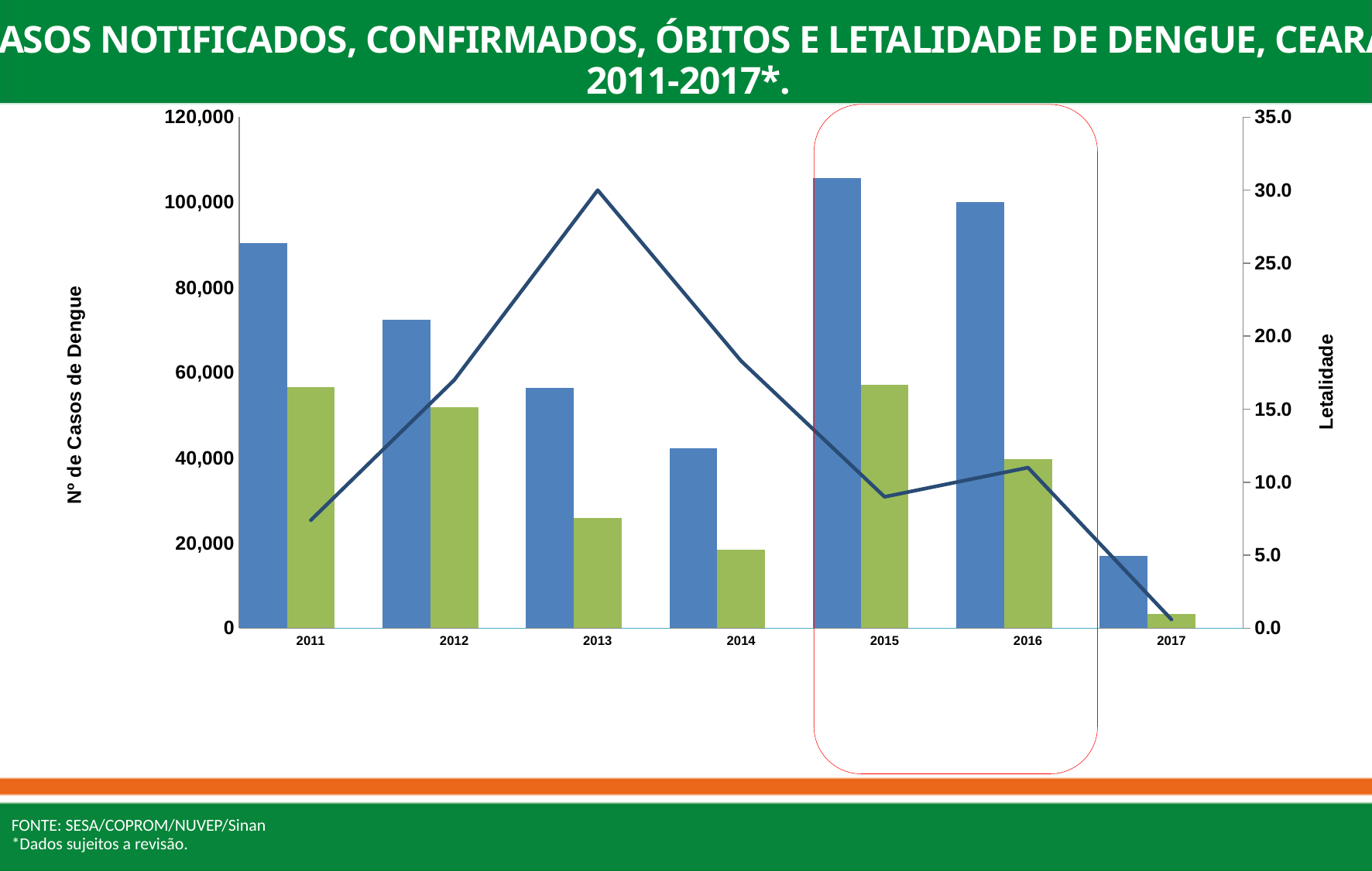
What is the title of the right-hand vertical axis? Letalidade Is the value of the green bar for 2014 greater or less than 20,000? less Is the value of the blue bar for 2017 greater or less than 20,000? less Which is larger, the blue bar for 2012 or the blue bar for 2013? 2012 How many years are shown on the x axis of the chart? 7 In which year is the blue bar the shortest? 2017 In which year is the blue bar the tallest? 2015 Is the line value (Letalidade) for 2013 greater or less than 25.0? greater What kind of chart is this? Combination bar and line chart In which year is the green bar the shortest? 2017 In which year does the line (Letalidade) reach its highest point? 2013